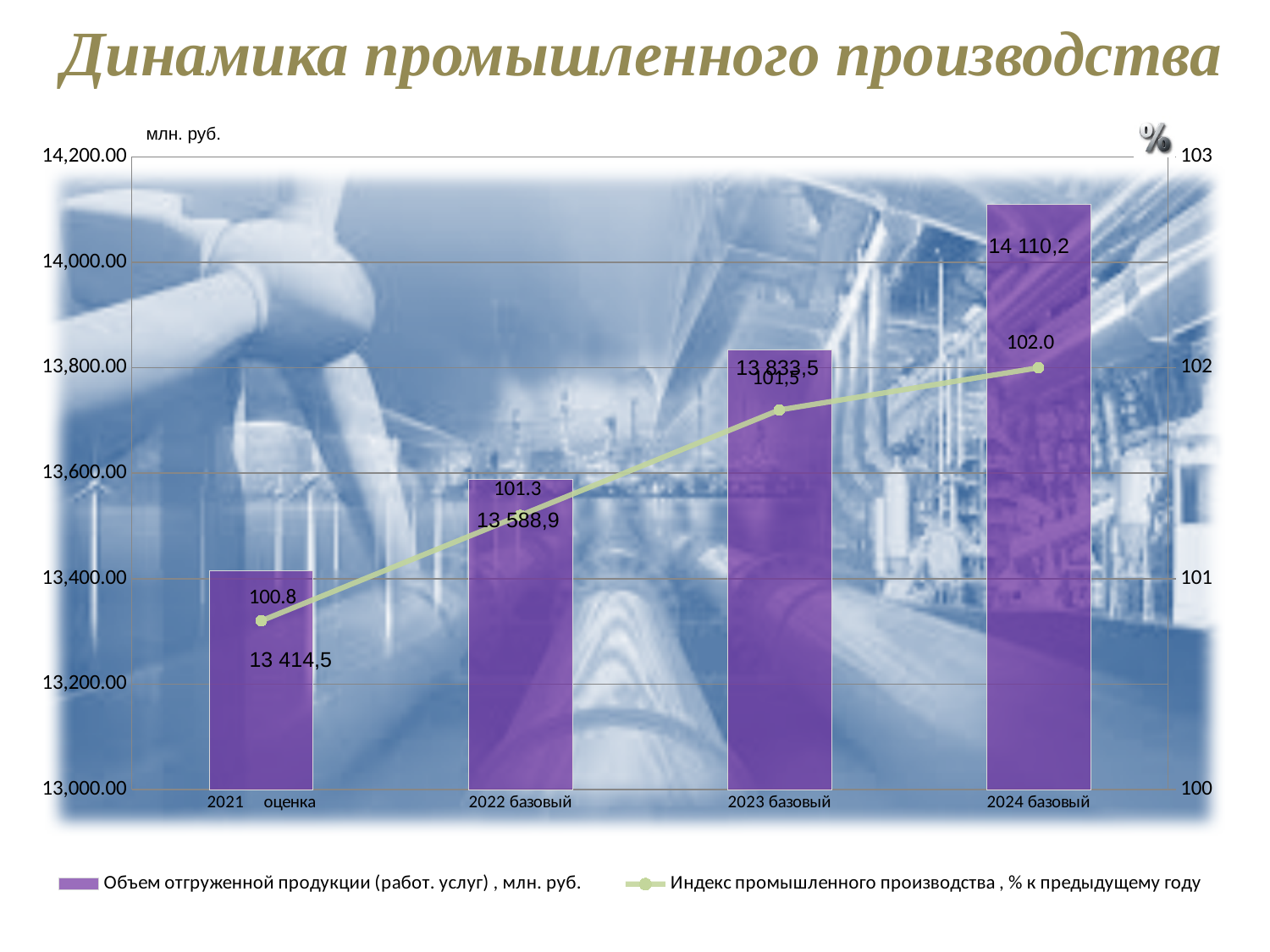
Which category has the lowest Индекс промышленного производства? 2021 оценка Do the Объем отгруженной продукции values rise or fall from 2021 to 2024? rise What is the difference between the Индекс промышленного производства values for 2024 базовый and 2021 оценка? 1.2 How many categories are shown on the x axis? 4 What is the value of Объем отгруженной продукции for 2024 базовый? 14 110,2 What is the Индекс промышленного производства value for 2022 базовый? 101.3 Which is larger, the Объем отгруженной продукции for 2022 базовый or for 2023 базовый? 2023 базовый What is the Индекс промышленного производства value for 2024 базовый? 102.0 What is the title of the chart? Динамика промышленного производства Which category has the highest Объем отгруженной продукции? 2024 базовый What is the value of Объем отгруженной продукции for 2021 оценка? 13 414,5 How many series does the legend list? 2